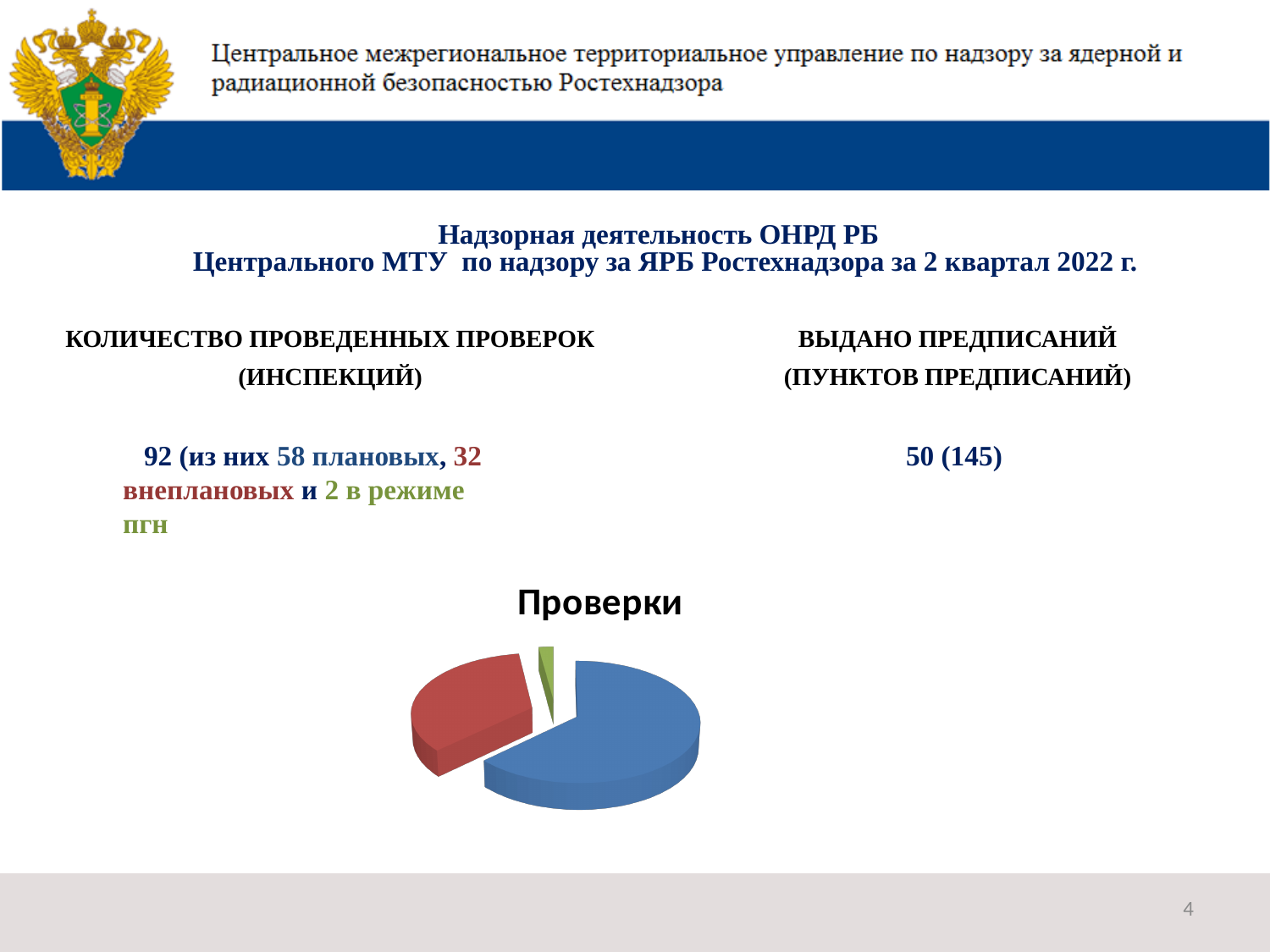
Is the blue slice more or less than half of the pie? more Does the pie chart have a legend? No How many slices does the pie chart have? 3 Which slice is larger, the blue slice or the red slice? the blue slice What kind of chart is shown on the slide? pie chart Which slice is larger, the red slice or the green slice? the red slice What is the title of the chart? Проверки Which slice of the pie chart is the largest? the blue slice Which slice of the pie chart is the smallest? the green slice